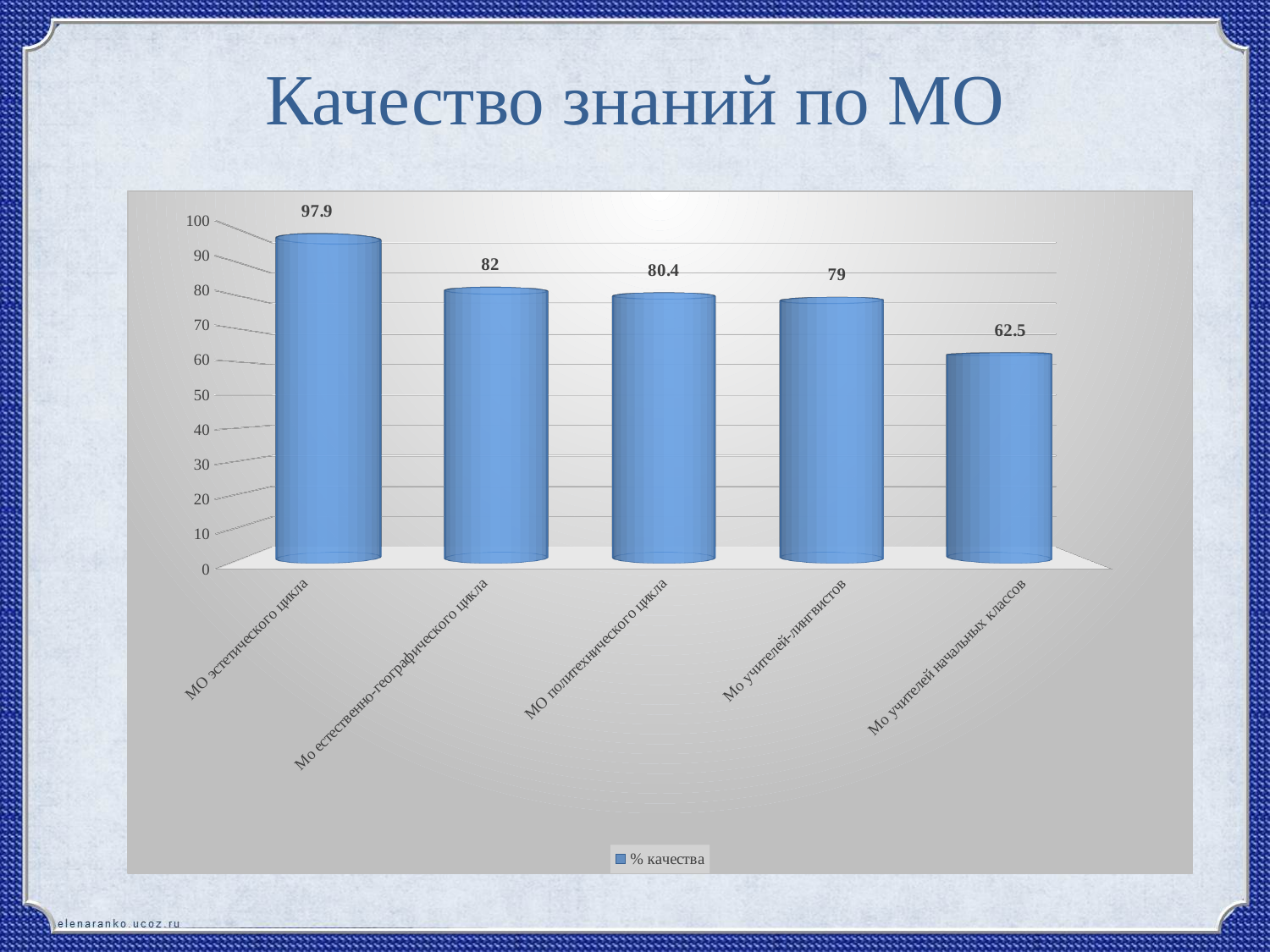
Which category has the lowest value? Мо учителей начальных классов Which category has the highest value? МО эстетического цикла What is the value for Мо учителей начальных классов? 62.5 How many categories are shown in the chart? 5 Which is larger: the value for Мо естественно-географического цикла or the value for Мо учителей-лингвистов? Мо естественно-географического цикла What is the difference between the values for МО эстетического цикла and Мо учителей начальных классов? 35.4 Is the value for Мо учителей-лингвистов greater or less than 70? greater What kind of chart is shown on the slide? bar chart What is the value for МО эстетического цикла? 97.9 What is the value for МО политехнического цикла? 80.4 What is the title of the slide? Качество знаний по МО How many series does the legend list? 1